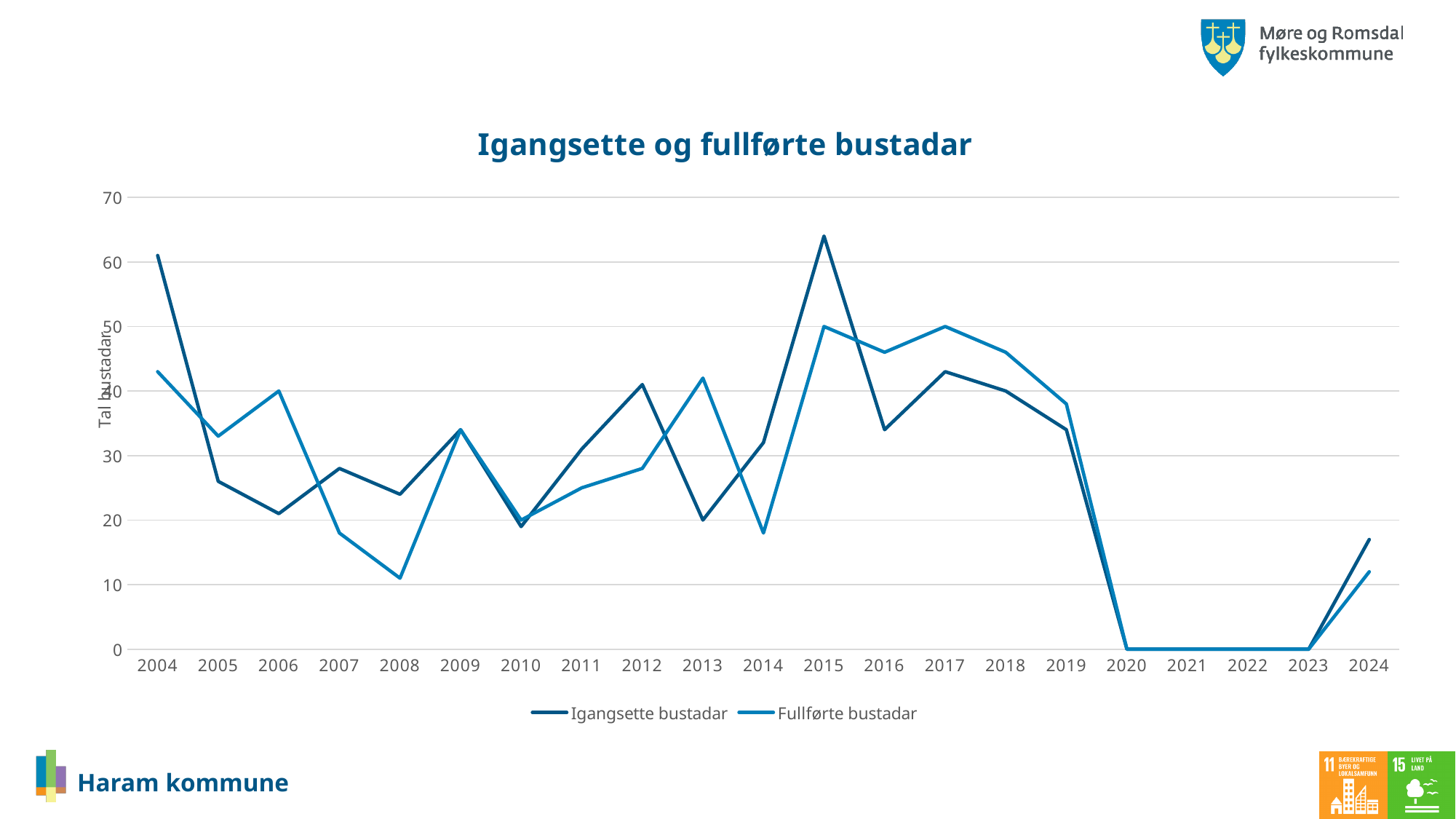
What is the title of the chart? Igangsette og fullførte bustadar What is the value of Igangsette bustadar in 2018? 40 What is the value of Fullførte bustadar in 2015? 50 How many years are shown on the x axis? 21 What type of chart is shown on the slide? line chart In which year does the Igangsette bustadar series reach its highest value? 2015 Is the value for Fullførte bustadar in 2008 greater or less than 20? less What is the value of Igangsette bustadar in 2021? 0 Do the values of Igangsette bustadar rise or fall from 2019 to 2020? fall Which series has the larger value in 2016, Igangsette bustadar or Fullførte bustadar? Fullførte bustadar How many series does the legend list? 2